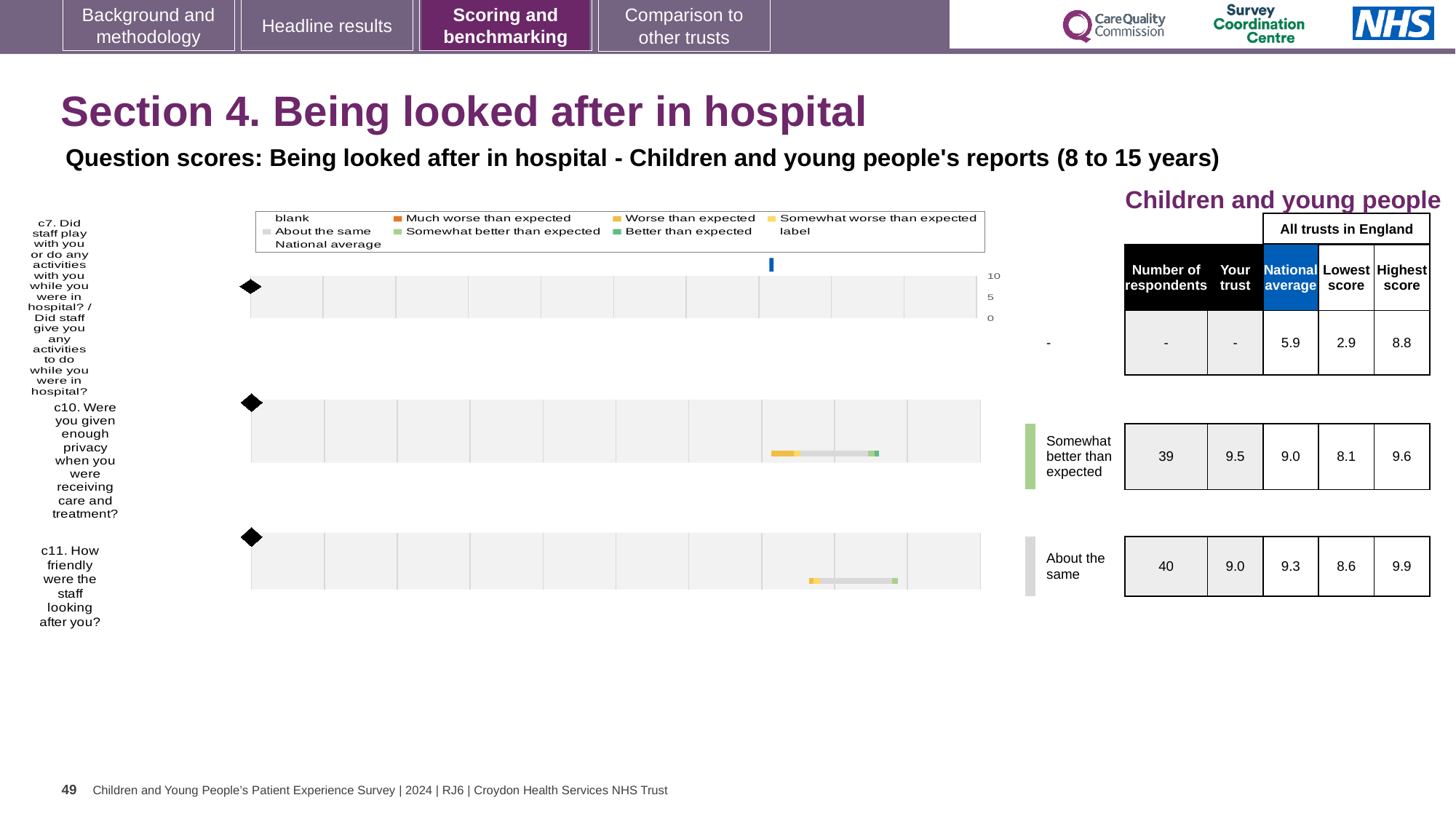
What is the lowest score across all trusts in England for c11 (How friendly were the staff)? 8.6 What kind of chart is shown on the slide? Bar chart How many questions are plotted in the chart? 3 What is the difference between the highest and lowest scores for c7 (Did staff play with you or do any activities with you)? 5.9 How many respondents answered c10 (Were you given enough privacy)? 39 What benchmark category is shown for c11 (How friendly were the staff looking after you?)? About the same For c10 (Were you given enough privacy), which is larger: the 'Your trust' score or the national average? Your trust What is the highest score across all trusts in England for c7 (Did staff play with you or do any activities with you)? 8.8 What is the national average score for c11 (How friendly were the staff looking after you?)? 9.3 What is the 'Your trust' score for c10 (Were you given enough privacy when you were receiving care and treatment?)? 9.5 What is the difference between the highest and lowest scores for c10 (Were you given enough privacy)? 1.5 For c11 (How friendly were the staff), which is larger: the 'Your trust' score or the national average? National average